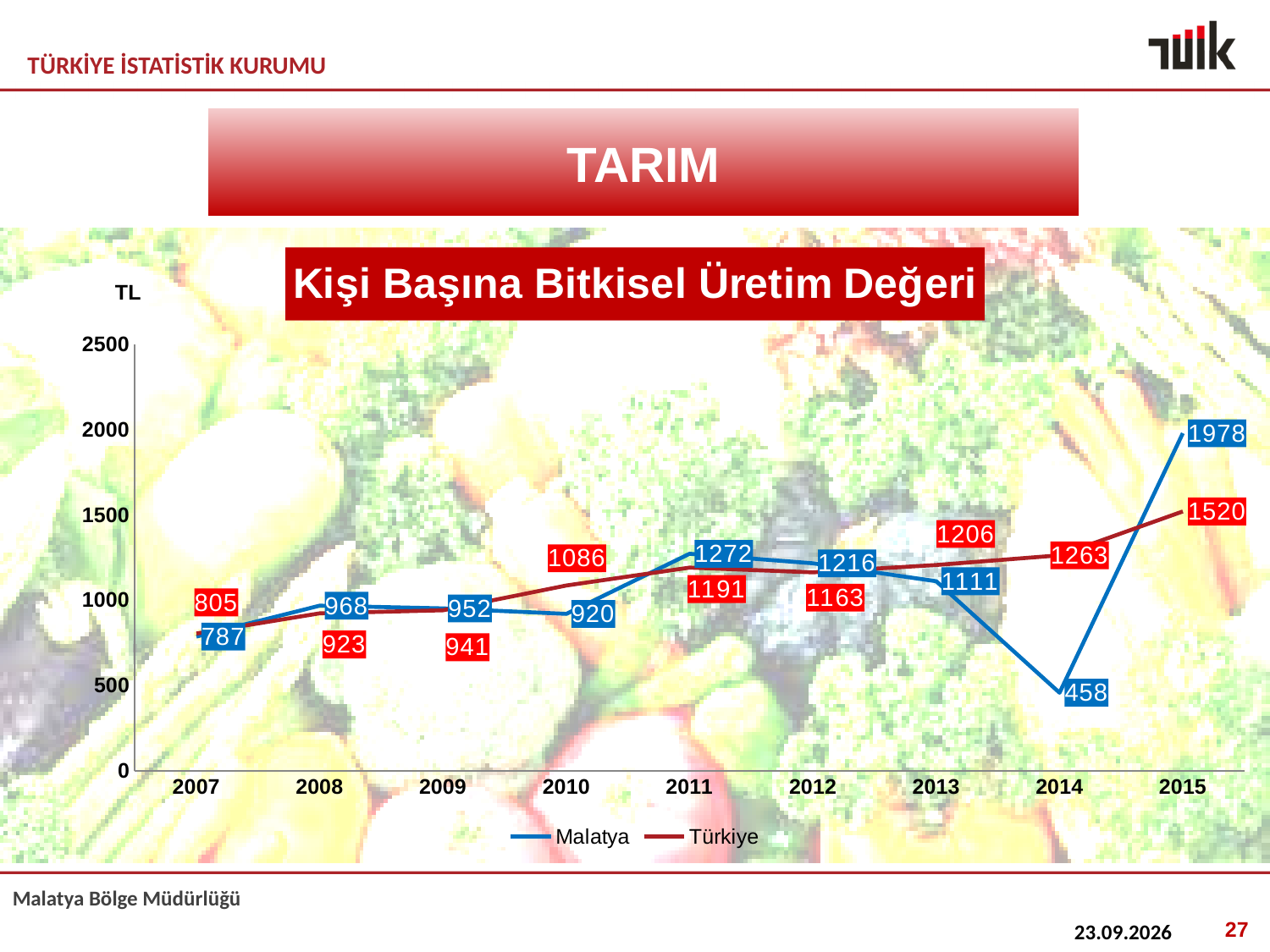
What type of chart is shown on the slide? line chart How many series does the legend list? 2 In which year is the Malatya value lowest? 2014 What is the value for Malatya in 2015? 1978 How many years are shown on the x axis? 9 Which is larger in 2013, the Malatya value or the Türkiye value? Türkiye What is the value for Malatya in 2014? 458 Does the Türkiye series rise or fall from 2007 to 2015? rise What is the value for Türkiye in 2010? 1086 In which year is the Türkiye value highest? 2015 What is the difference between the Malatya and Türkiye values in 2015? 458 What is the title of the chart? Kişi Başına Bitkisel Üretim Değeri